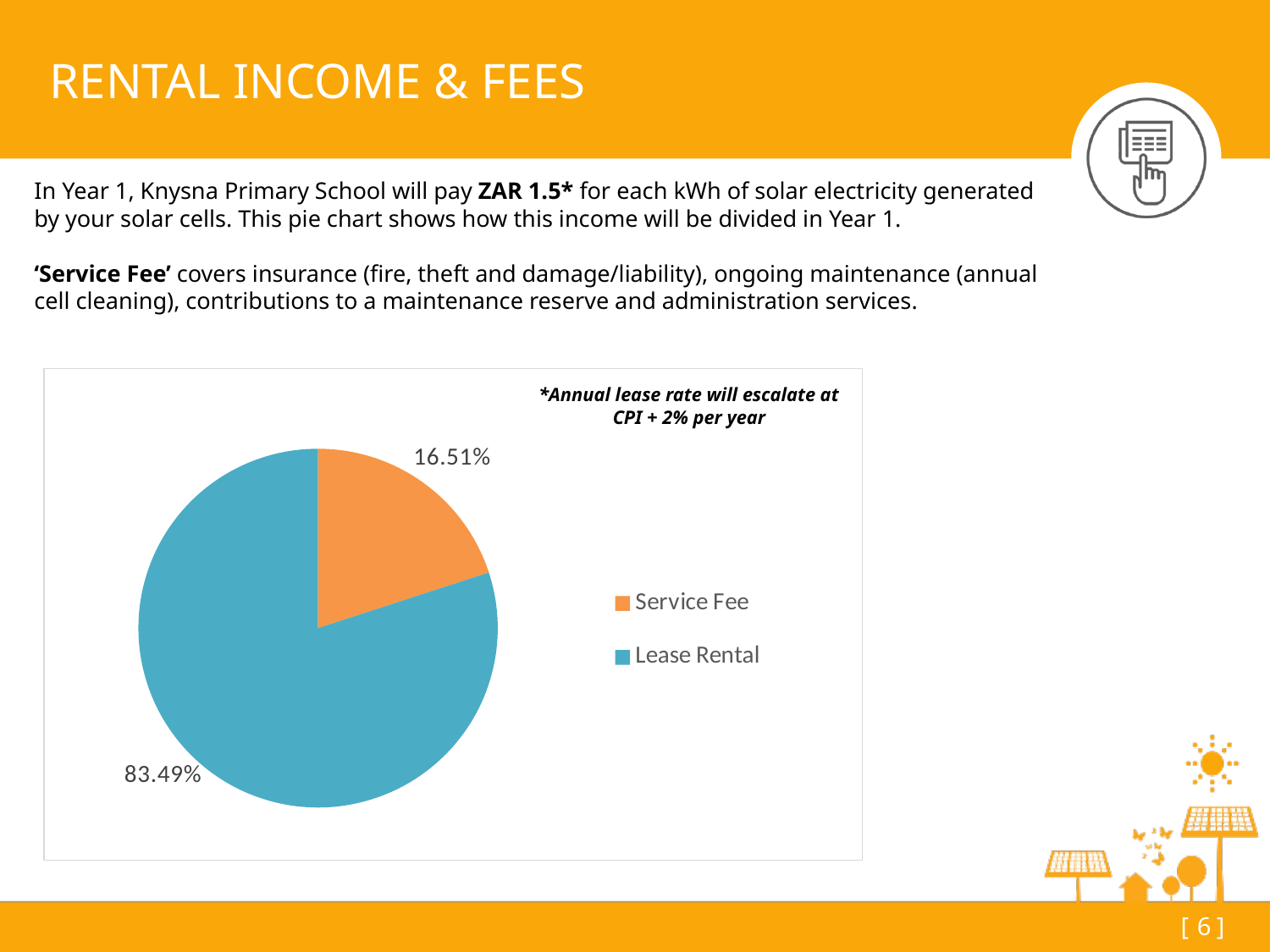
Which slice of the pie chart is the largest? Lease Rental What colour is the Lease Rental slice? Blue What kind of chart is shown on the slide? Pie chart How many entries does the legend list? 2 How many slices does the pie chart have? 2 What share of the pie does Lease Rental represent? 83.49% What is the difference in percentage points between the Lease Rental and Service Fee slices? 66.98 What colour is the Service Fee slice? Orange Which is larger, the Service Fee slice or the Lease Rental slice? Lease Rental What share of the pie does Service Fee represent? 16.51% Which slice of the pie chart is the smallest? Service Fee